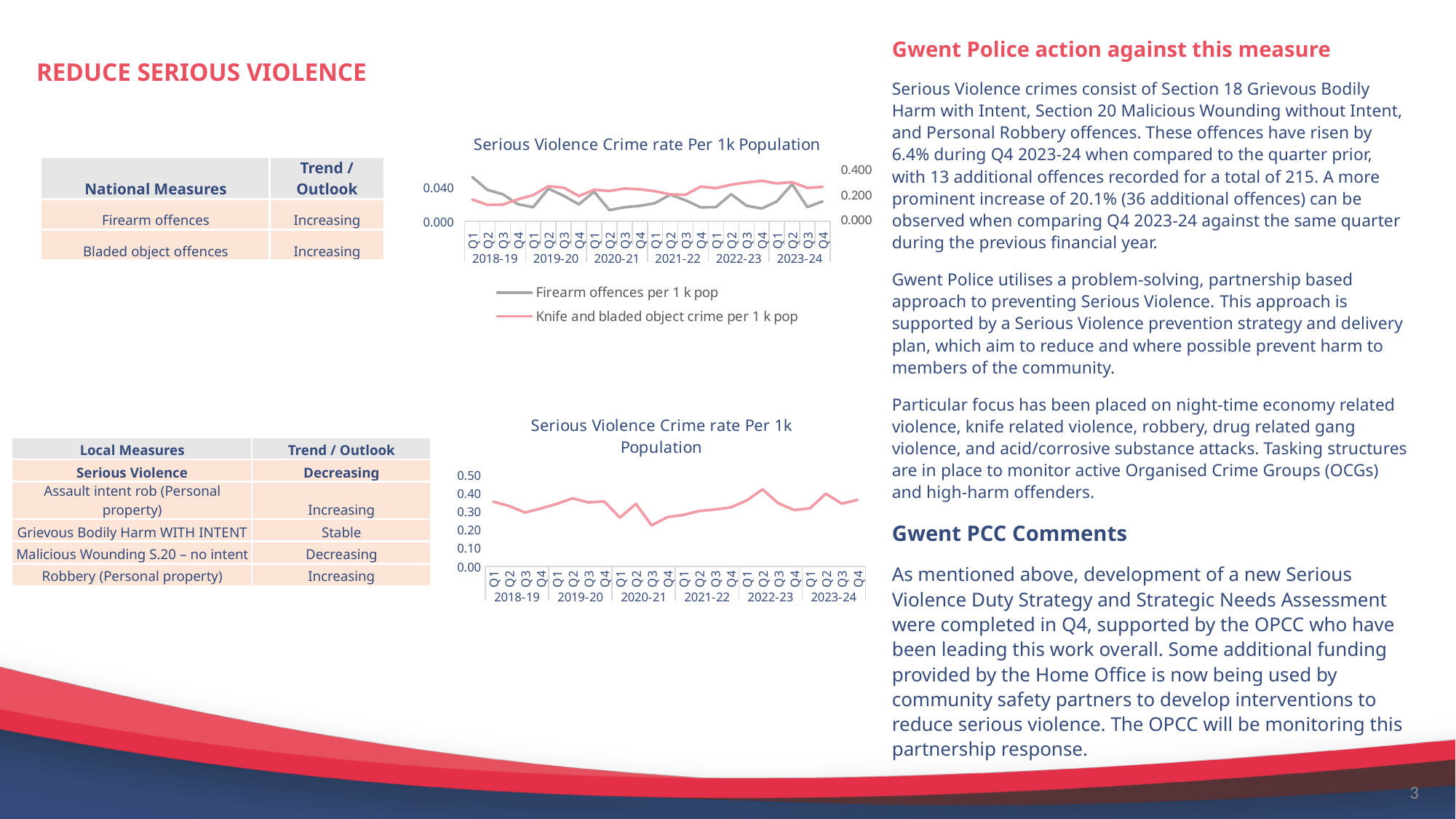
How many quarterly data points are plotted in the bottom chart? 24 In the bottom chart, is the value for Q3 2020-21 greater or less than 0.30? less In the top chart, does the Knife and bladed object crime per 1 k pop line generally rise or fall from 2018-19 to 2023-24? rise In the top chart, what are the two series named in the legend? Firearm offences per 1 k pop; Knife and bladed object crime per 1 k pop In the bottom chart, is the value for Q1 2018-19 greater or less than 0.30? greater How many financial years are shown along the x axis of the bottom chart? 6 What is the title of the top chart? Serious Violence Crime rate Per 1k Population What kind of chart is the top chart on the slide? line chart In the bottom chart, which quarter has the highest crime rate? Q2 2022-23 What kind of chart is the bottom chart on the slide? line chart How many series does the legend of the top chart list? 2 In the bottom chart, which quarter has the lowest crime rate? Q3 2020-21